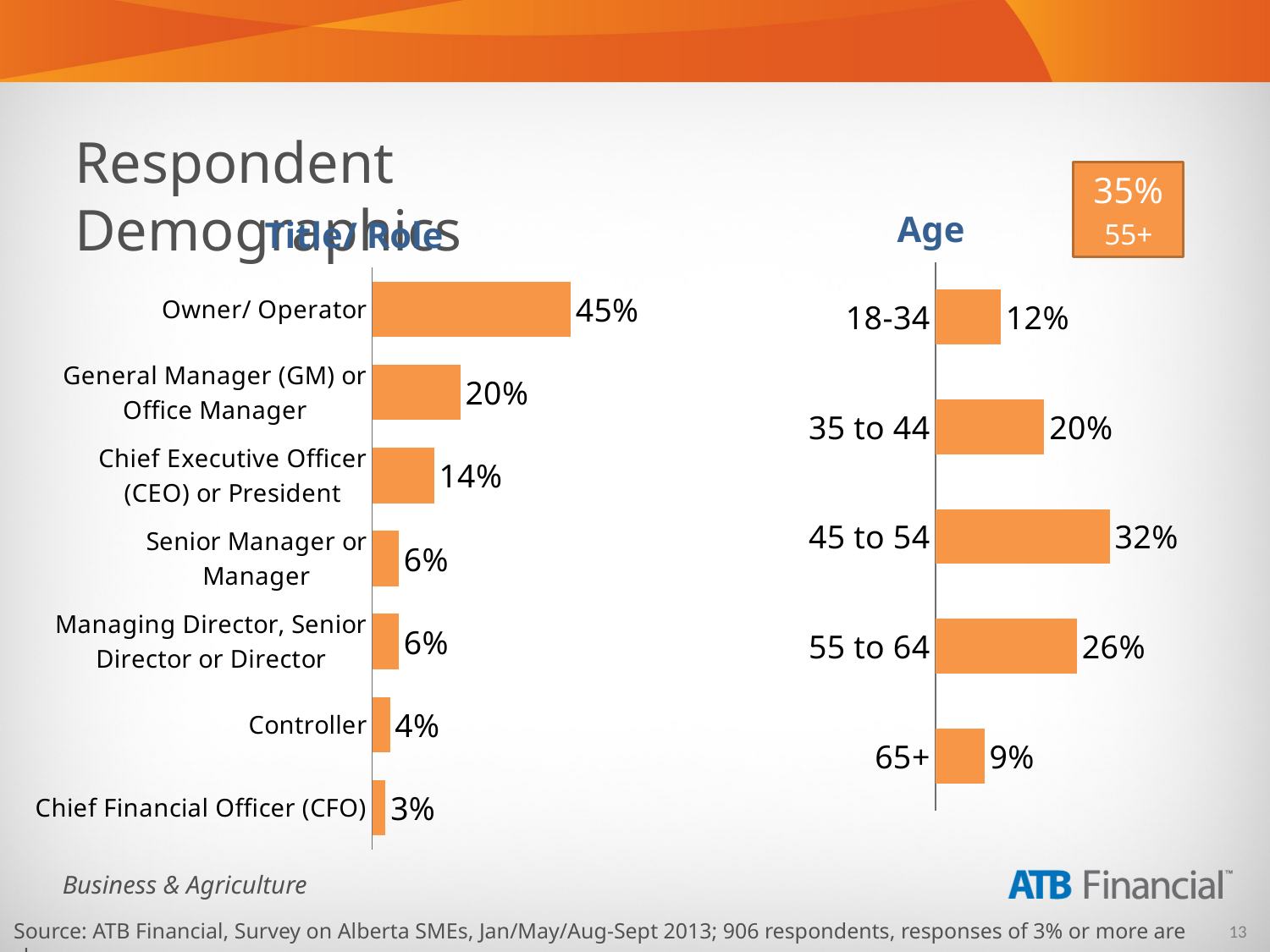
In the Age chart, which age group has the highest value? 45 to 54 In the Age chart, what is the difference between 55 to 64 and 18-34? 14% In the Title/Role chart, what percentage of respondents are Owner/ Operator? 45% In the Age chart, how many age groups are shown? 5 In the Title/Role chart, how many categories are shown? 7 In the Title/Role chart, what is the value for Controller? 4% In the Title/Role chart, what is the difference between Owner/ Operator and General Manager (GM) or Office Manager? 25% What type of chart is the Age chart? Bar chart In the Age chart, what is the value for 65+? 9% In the Age chart, what is the value for 45 to 54? 32% In the Title/Role chart, which category has the lowest value? Chief Financial Officer (CFO) In the Age chart, which is larger, 35 to 44 or 55 to 64? 55 to 64